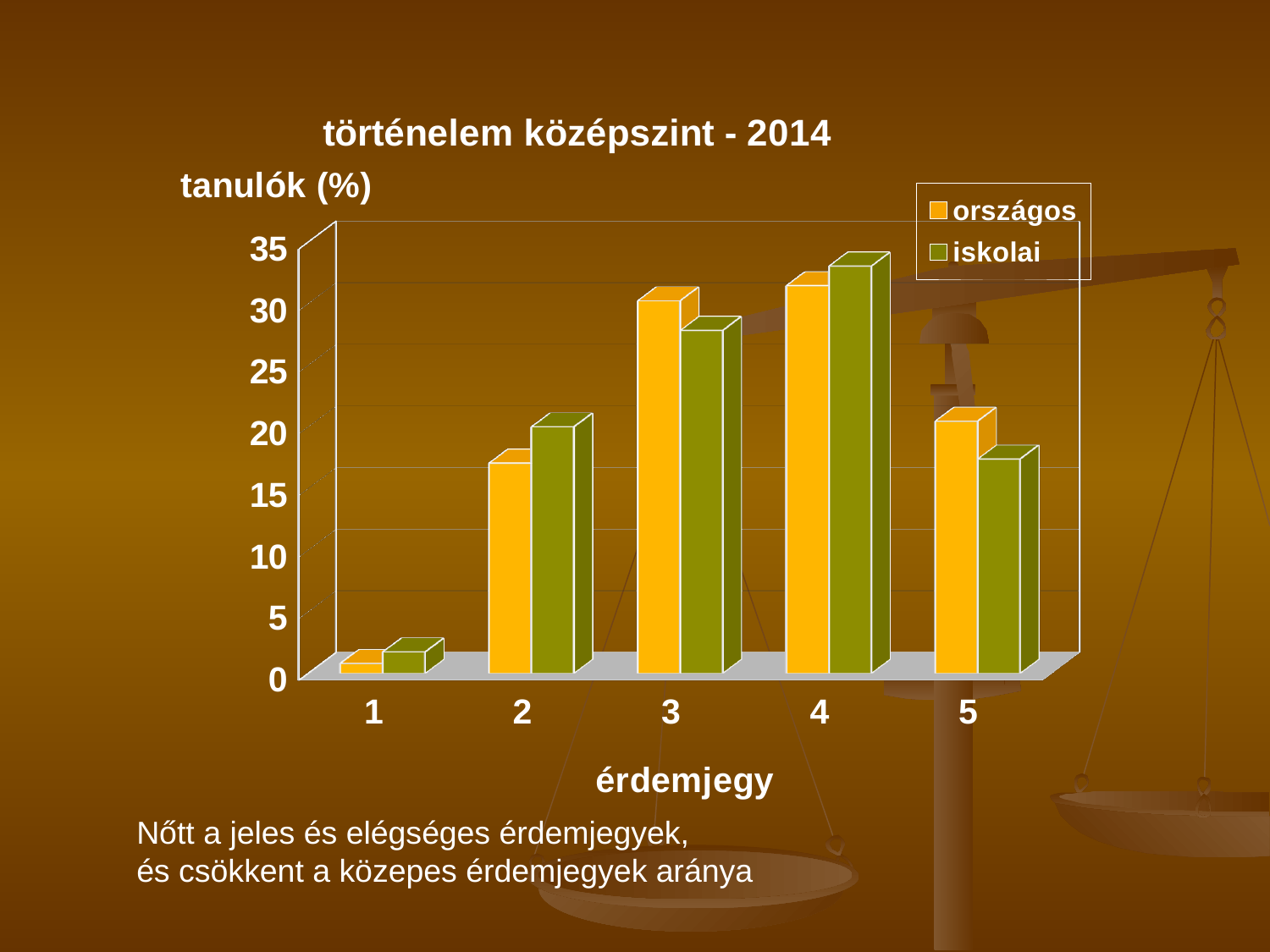
What kind of chart is shown on the slide? bar chart Which two series are listed in the legend? országos, iskolai For érdemjegy 5, which is larger: the országos value or the iskolai value? országos How many series does the legend list? 2 Is the országos value for érdemjegy 5 greater or less than 15? greater For érdemjegy 3, which is larger: the országos value or the iskolai value? országos For which érdemjegy is the országos value lowest? 1 Is the iskolai value for érdemjegy 2 greater or less than 25? less What is the title of the chart? történelem középszint - 2014 For érdemjegy 2, which is larger: the országos value or the iskolai value? iskolai How many grade categories (érdemjegy) are shown on the x axis? 5 For which érdemjegy is the iskolai value highest? 4